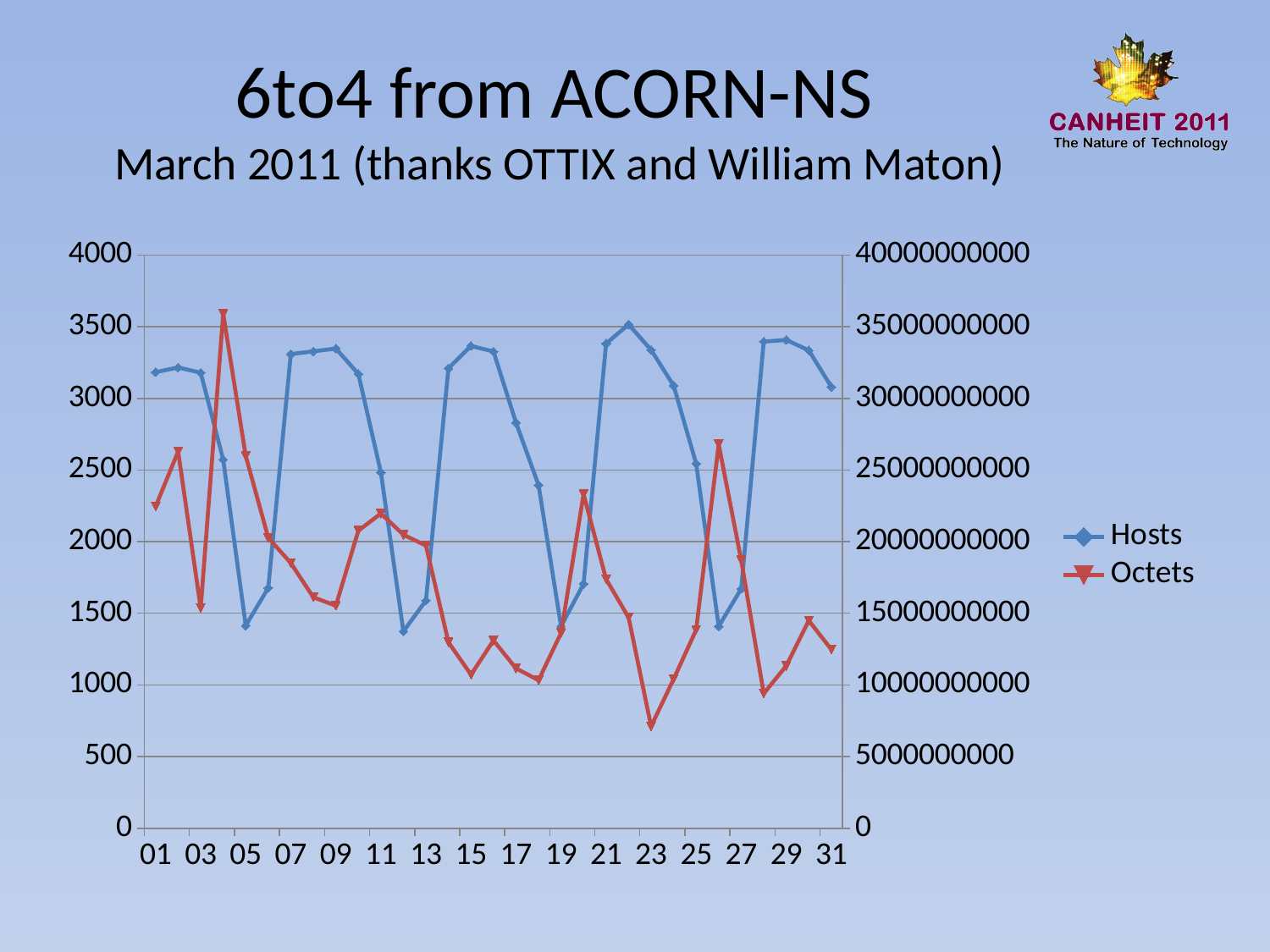
On which day does the Octets series reach its highest value? 04 How many days (data points) are plotted along the x axis? 31 How many series does the legend list? 2 Is the Hosts value on day 05 greater or less than 1500? less On which day does the Hosts series reach its highest value? 22 Is the Octets value on day 23 greater or less than 10000000000? less Is the Hosts value on day 01 greater or less than 3000? greater What are the names of the two series in the legend? Hosts and Octets Which is larger, the Hosts value on day 22 or on day 05? day 22 What kind of chart is shown on the slide? line chart On which day does the Octets series reach its lowest value? 23 What is the maximum value shown on the right-hand (Octets) axis? 40000000000